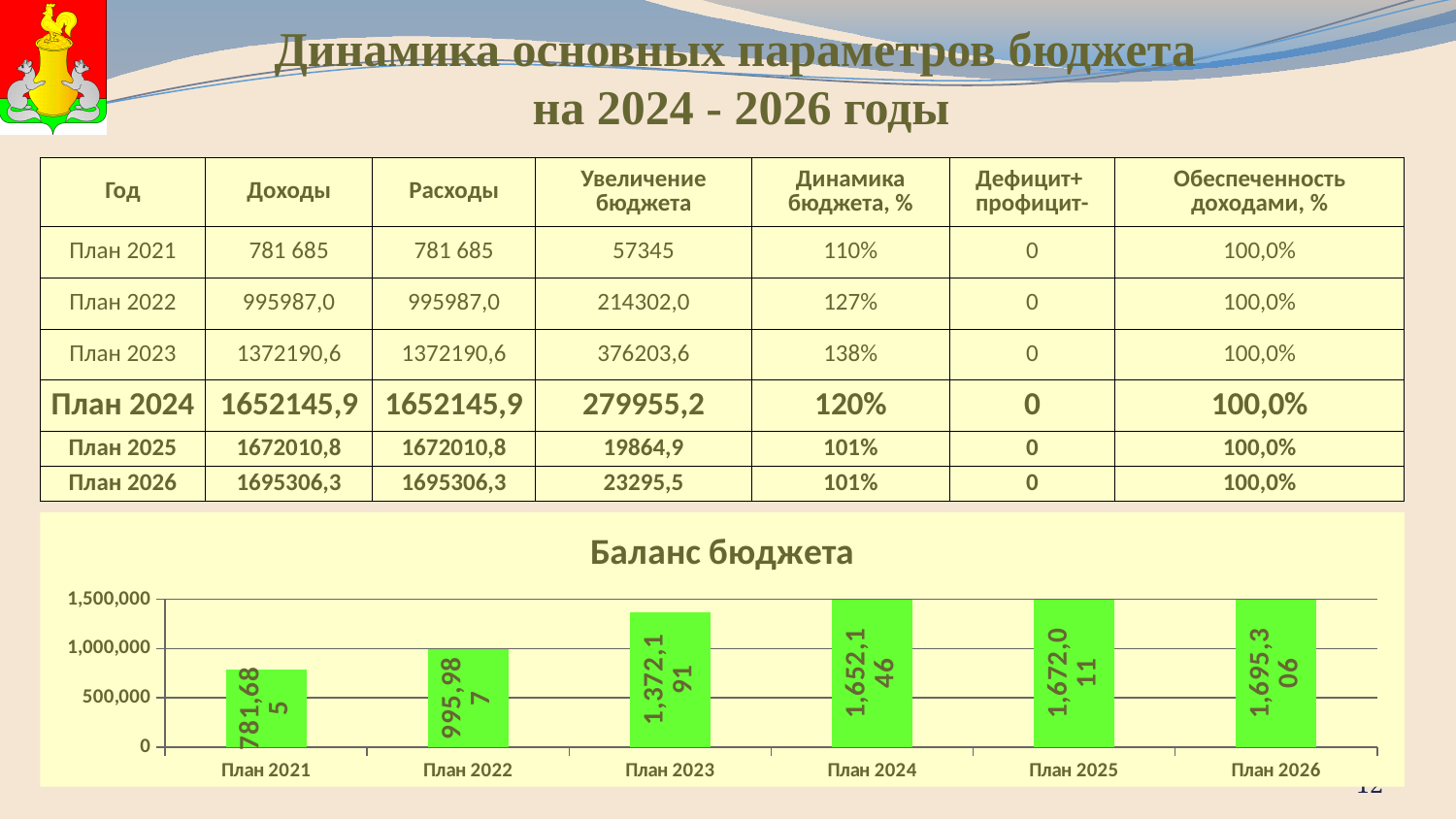
Which category has the lowest value in the Баланс бюджета chart? План 2021 What is the difference between the values for План 2026 and План 2025 in the Баланс бюджета chart? 23,295 In the Баланс бюджета chart, is the value for План 2021 greater or less than 1,000,000? less What is the value for План 2026 in the Баланс бюджета chart? 1,695,306 Do the values in the Баланс бюджета chart rise or fall from План 2021 to План 2026? rise How many categories are shown on the x axis of the Баланс бюджета chart? 6 What kind of chart is the Баланс бюджета chart? bar chart What is the value for План 2023 in the Баланс бюджета chart? 1,372,191 Which category has the highest value in the Баланс бюджета chart? План 2026 What is the value for План 2021 in the Баланс бюджета chart? 781,685 What is the difference between the values for План 2022 and План 2021 in the Баланс бюджета chart? 214,302 In the Баланс бюджета chart, which is larger: the value for План 2023 or the value for План 2022? План 2023